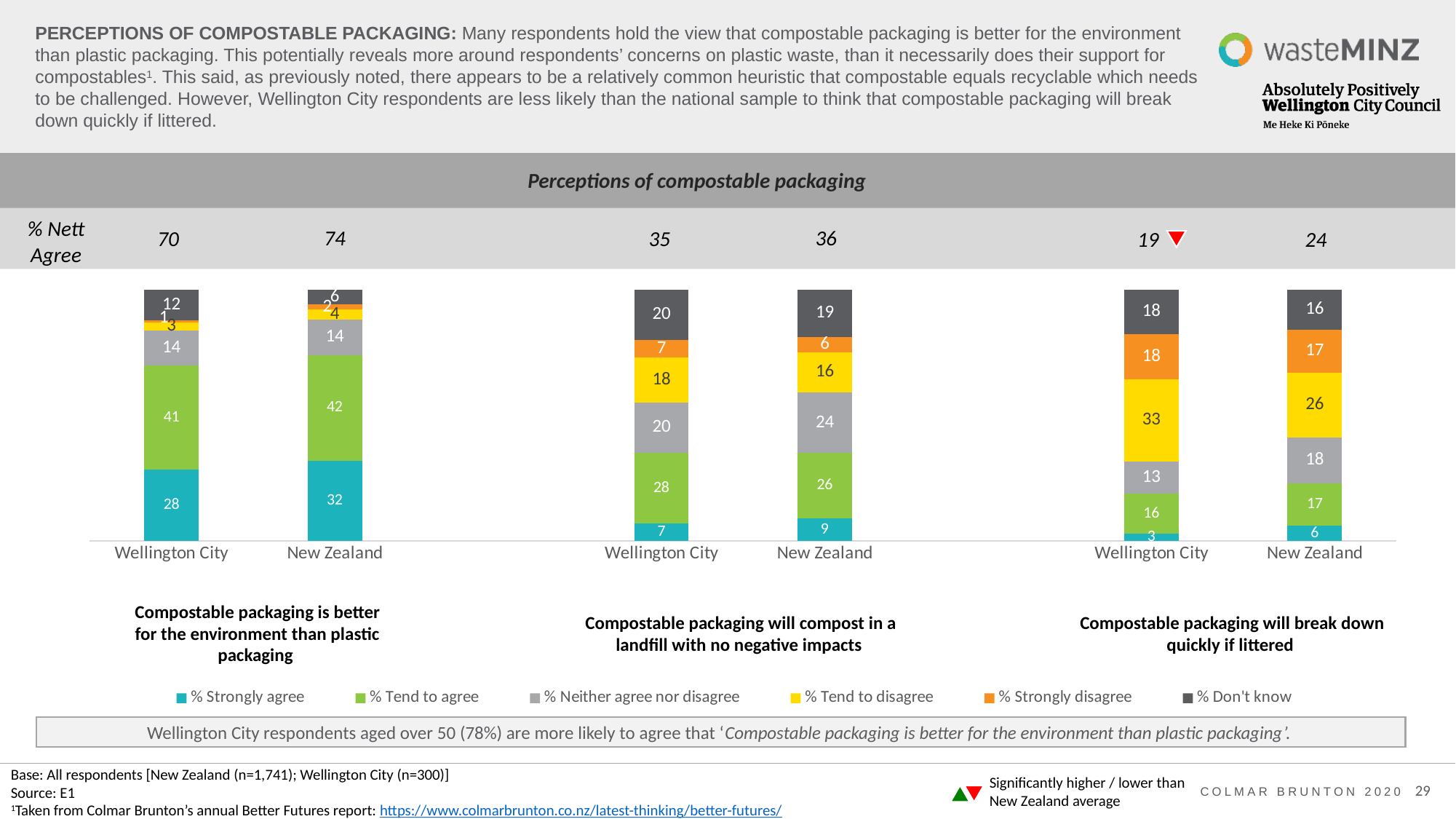
What type of chart is shown on the slide? Stacked bar chart What is the % Strongly agree value for Wellington City for 'Compostable packaging is better for the environment than plastic packaging'? 28 What is the difference in % Nett Agree between New Zealand and Wellington City for 'Compostable packaging is better for the environment than plastic packaging'? 4 What is the % Don't know value for New Zealand for 'Compostable packaging will compost in a landfill with no negative impacts'? 19 Which has the higher % Tend to agree value for 'Compostable packaging will compost in a landfill with no negative impacts', Wellington City or New Zealand? Wellington City How many series does the legend list? 6 Which statement has the highest % Nett Agree for New Zealand? Compostable packaging is better for the environment than plastic packaging Which statement has the lowest % Nett Agree for Wellington City? Compostable packaging will break down quickly if littered How many bars are plotted in the chart? 6 What is the % Tend to disagree value for Wellington City for 'Compostable packaging will break down quickly if littered'? 33 What is the title of the chart? Perceptions of compostable packaging What is the % Nett Agree for Wellington City for 'Compostable packaging will break down quickly if littered'? 19